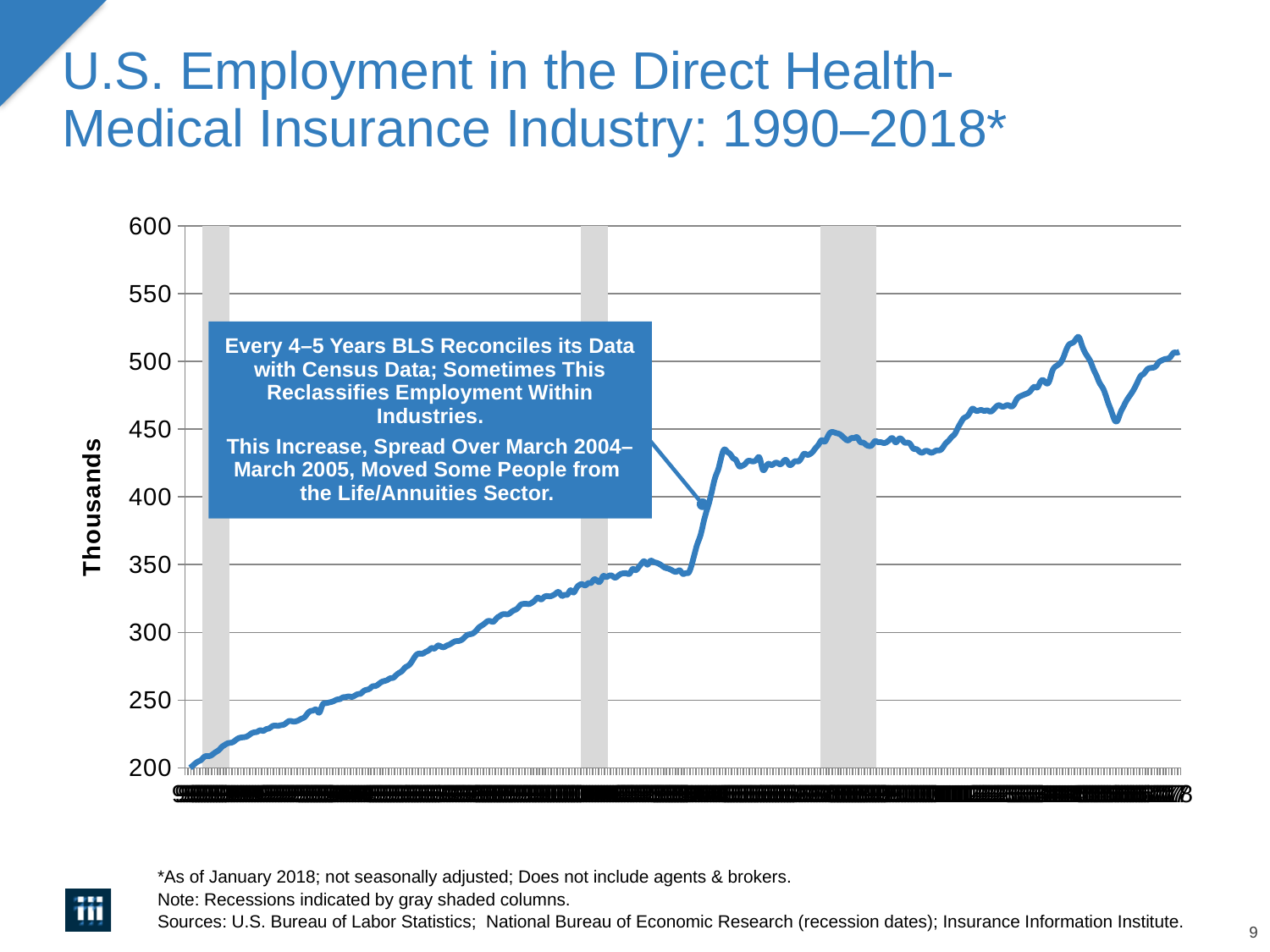
What kind of chart is shown on the slide? Line chart Is the value at the start of the series (1990) greater or less than 250? less What is the title of the chart on the slide? U.S. Employment in the Direct Health-Medical Insurance Industry: 1990–2018* What do the gray shaded columns on the chart indicate? Recessions Is the value at the end of the series (January 2018) greater or less than 500? greater Is the value at the end of the series greater or less than 550? less What is the label on the vertical axis? Thousands How many gray shaded recession columns appear on the chart? 3 Overall, do the values rise or fall from the left of the chart to the right? Rise